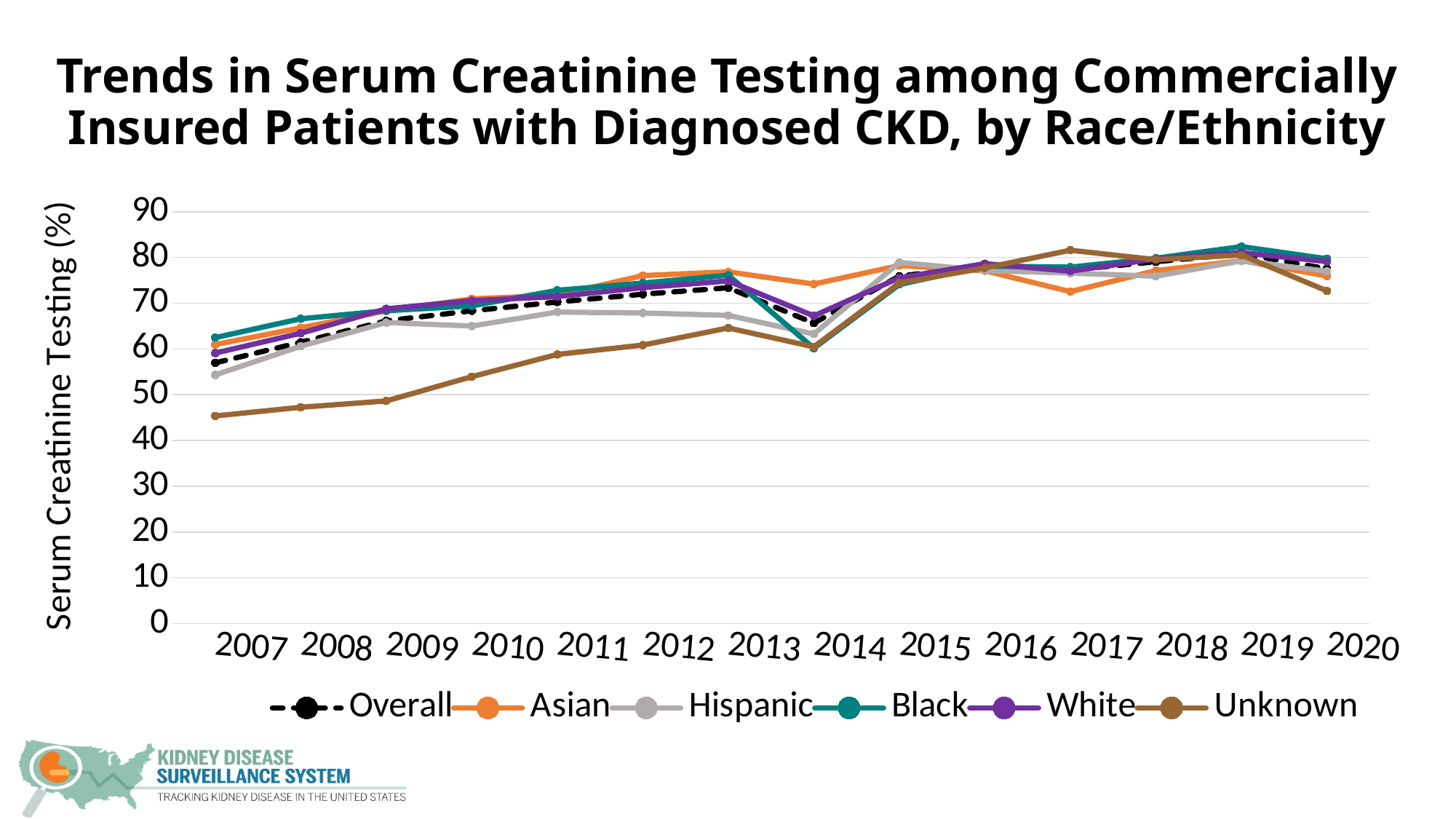
What kind of chart is shown on the slide? line chart Is the value for Black in 2007 greater or less than 60? greater Which is larger in 2007, the value for Black or the value for Unknown? Black How many series does the legend list? 6 Is the value for Black in 2014 greater or less than 70? less Does the Unknown series generally rise or fall from 2007 to 2017? rise How many years are plotted along the x axis? 14 Is the value for Unknown in 2020 greater or less than 80? less What is the title of the y axis? Serum Creatinine Testing (%) Which series has the lowest value in 2007? Unknown Which series has the highest value in 2014? Asian